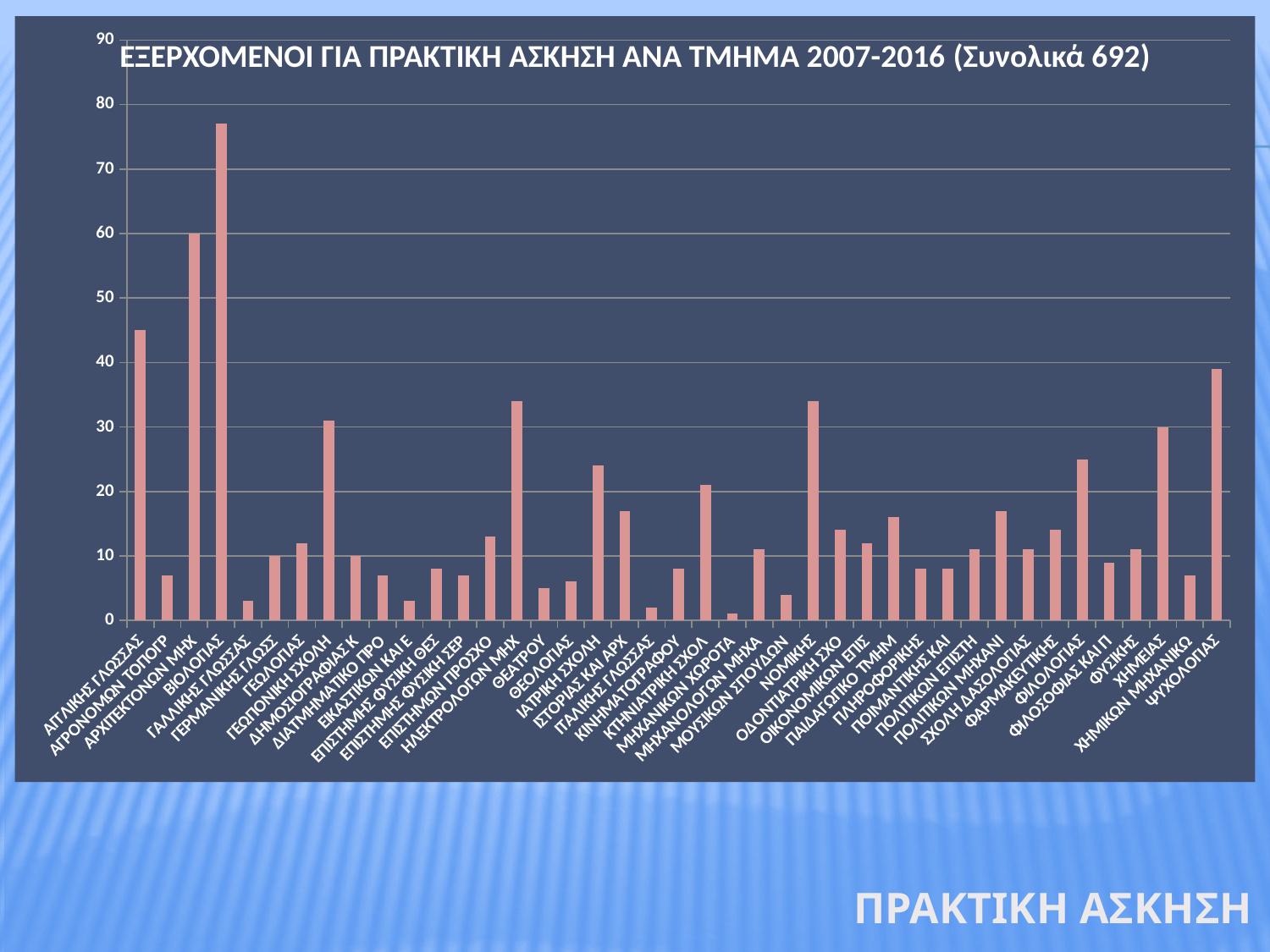
Which has a larger value, ΑΓΓΛΙΚΗΣ ΓΛΩΣΣΑΣ or ΑΓΡΟΝΟΜΩΝ ΤΟΠΟΓΡ? ΑΓΓΛΙΚΗΣ ΓΛΩΣΣΑΣ Is the value for ΑΓΓΛΙΚΗΣ ΓΛΩΣΣΑΣ greater or less than 40? greater Is the value for ΨΥΧΟΛΟΓΙΑΣ greater or less than 30? greater Which department has the highest number of outgoing students? ΒΙΟΛΟΓΙΑΣ Is the value for ΑΓΡΟΝΟΜΩΝ ΤΟΠΟΓΡ greater or less than 10? less What is the title of the chart? ΕΞΕΡΧΟΜΕΝΟΙ ΓΙΑ ΠΡΑΚΤΙΚΗ ΑΣΚΗΣΗ ΑΝΑ ΤΜΗΜΑ 2007-2016 (Συνολικά 692) What kind of chart is shown on the slide? bar chart Which has a larger value, ΒΙΟΛΟΓΙΑΣ or ΑΡΧΙΤΕΚΤΟΝΩΝ ΜΗΧ? ΒΙΟΛΟΓΙΑΣ According to the chart title, what is the total number of outgoing students for practical training across all departments? 692 What is the maximum value shown on the vertical axis? 90